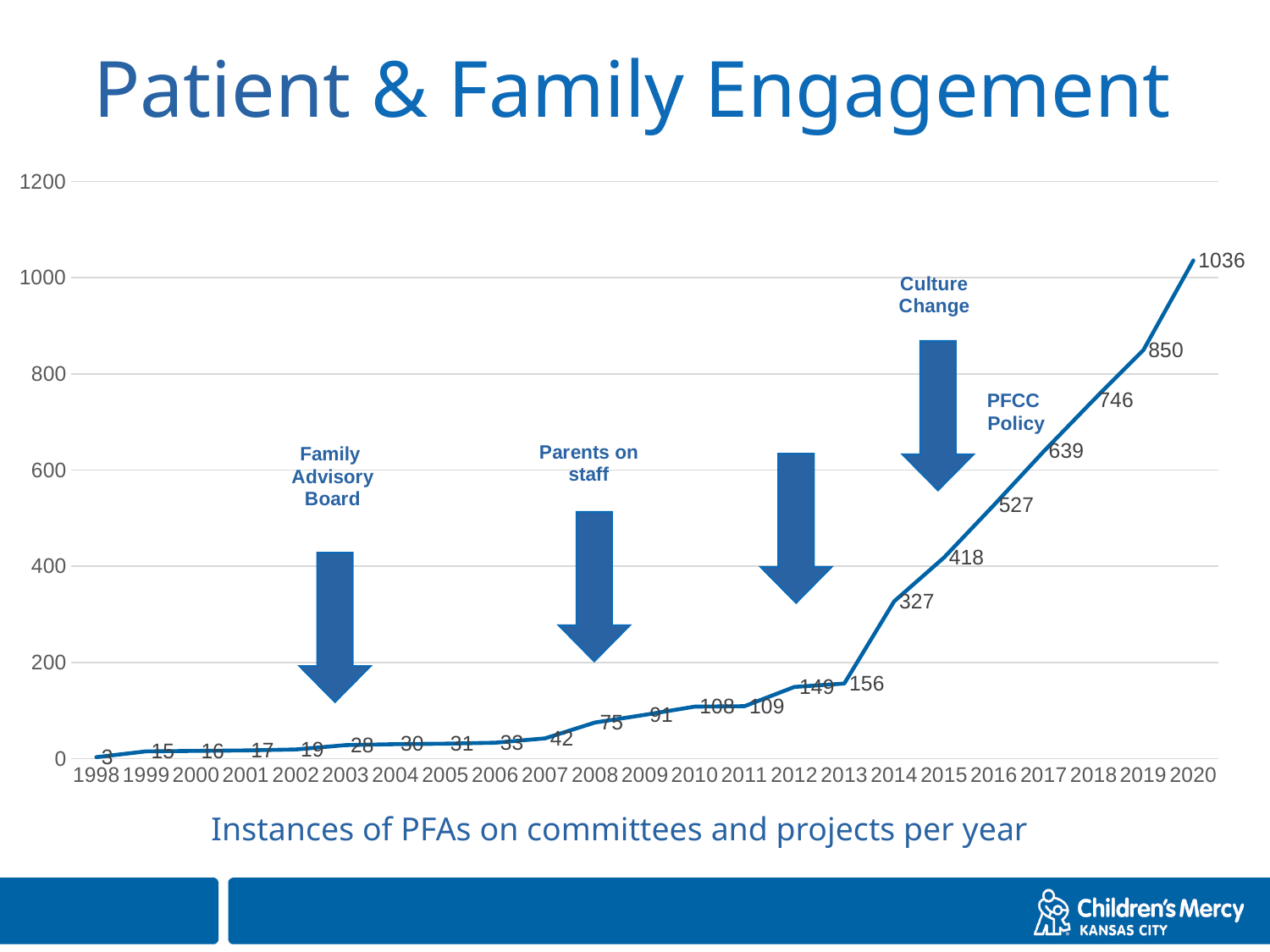
What is the value for 2014? 327 What kind of chart is shown on the slide? line chart How many years are plotted on the x axis? 23 What is the difference between the values for 2014 and 2013? 171 Which year has the lowest value? 1998 Which year has the highest value? 2020 What is the value for 2020? 1036 What is the value for 2008? 75 Do the values generally rise or fall from 1998 to 2020? rise What is the value for 1998? 3 What is the difference between the values for 2020 and 2019? 186 Which is larger, the value for 2016 or the value for 2017? 2017